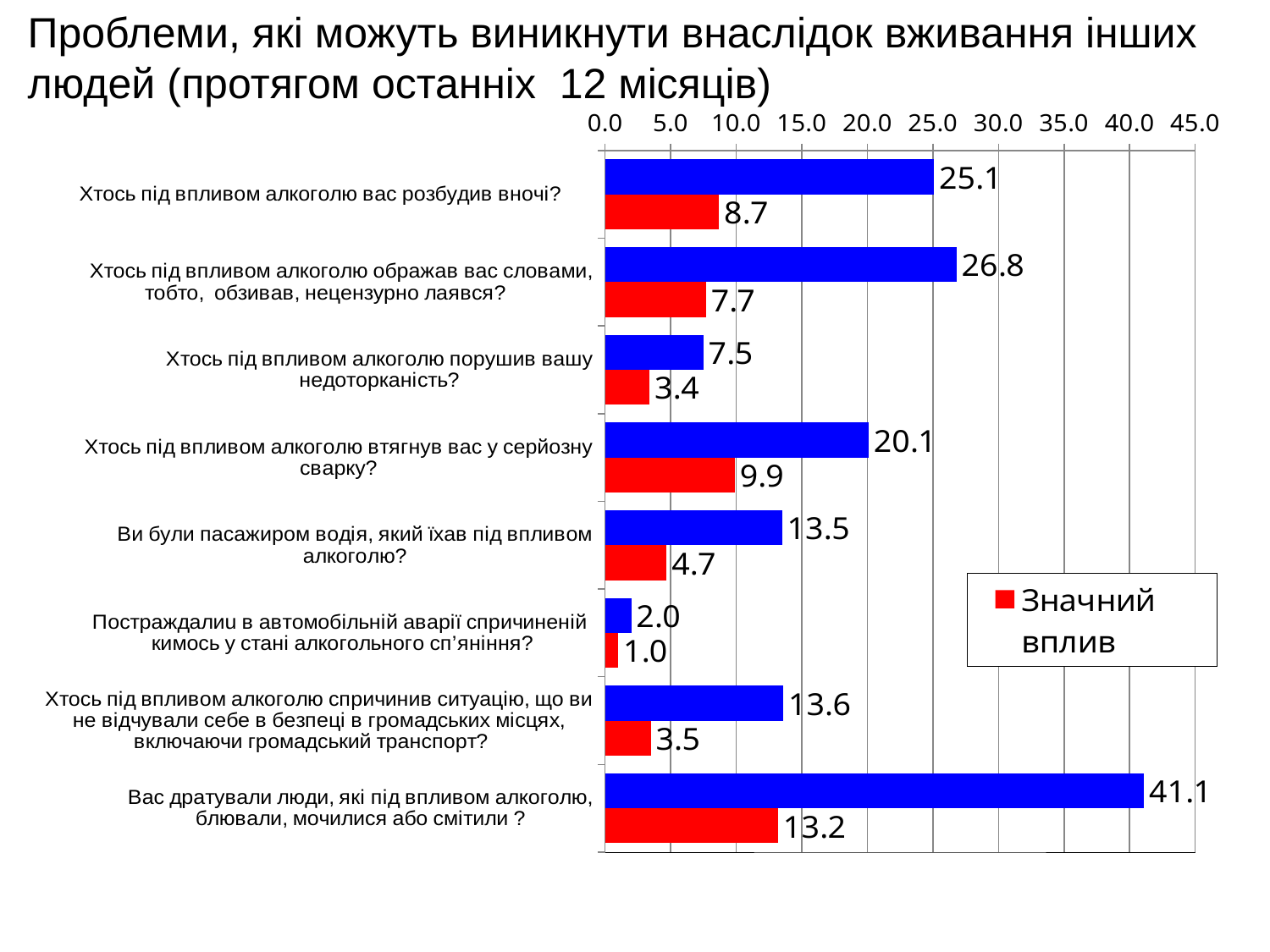
What kind of chart is shown on the slide? bar chart Which category has the lowest red bar (Значний вплив) value? Постраждалии в автомобільній аварії спричиненій кимось у стані алкогольного сп’яніння? How many categories (questions) are listed on the chart? 8 What is the difference between the blue bar and the red bar for "Хтось під впливом алкоголю вас розбудив вночі?"? 16.4 How many series does the legend list? 1 What is the value of the blue bar for "Хтось під впливом алкоголю порушив вашу недоторканість?"? 7.5 What is the value of the red bar (Значний вплив) for "Хтось під впливом алкоголю втягнув вас у серйозну сварку?"? 9.9 What is the legend entry shown on the chart? Значний вплив What is the value of the red bar (Значний вплив) for "Постраждалии в автомобільній аварії спричиненій кимось у стані алкогольного сп’яніння?"? 1.0 Which category has the highest blue bar value? Вас дратували люди, які під впливом алкоголю, блювали, мочилися або смітили ? Which is larger: the red bar (Значний вплив) for "Хтось під впливом алкоголю вас розбудив вночі?" or for "Хтось під впливом алкоголю ображав вас словами, тобто, обзивав, нецензурно лаявся?"? Хтось під впливом алкоголю вас розбудив вночі? What is the value of the blue bar for "Вас дратували люди, які під впливом алкоголю, блювали, мочилися або смітили ?"? 41.1